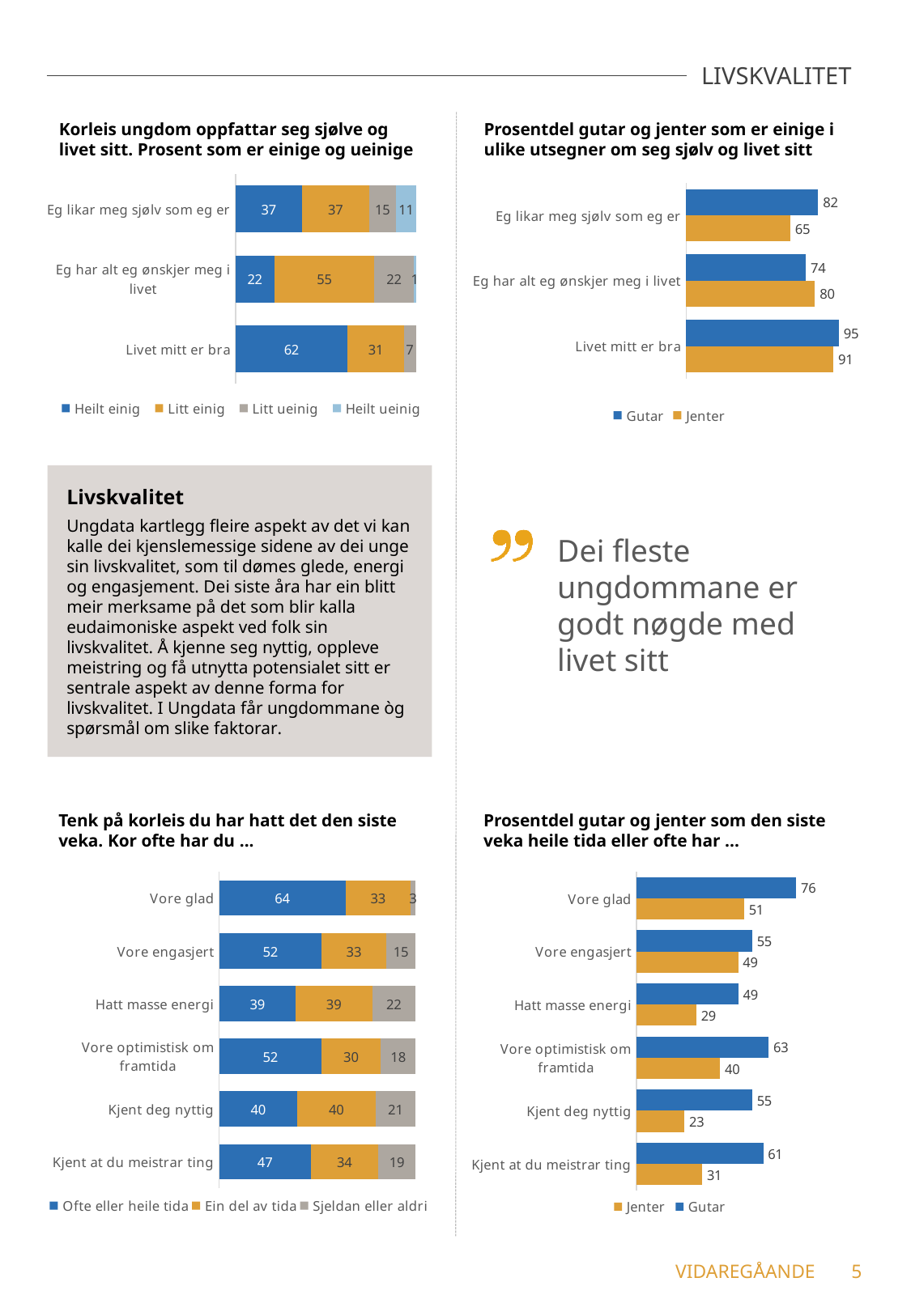
In the chart 'Prosentdel gutar og jenter som er einige i ulike utsegner om seg sjølv og livet sitt', what is the difference between Gutar and Jenter for 'Eg likar meg sjølv som eg er'? 17 In the chart 'Prosentdel gutar og jenter som er einige i ulike utsegner om seg sjølv og livet sitt', which is larger for 'Eg har alt eg ønskjer meg i livet', Gutar or Jenter? Jenter In the chart 'Prosentdel gutar og jenter som den siste veka heile tida eller ofte har …', what is the Jenter value for 'Kjent deg nyttig'? 23 In the chart 'Korleis ungdom oppfattar seg sjølve og livet sitt', how many series does the legend list? 4 In the chart 'Tenk på korleis du har hatt det den siste veka', how many categories are shown? 6 In the chart 'Prosentdel gutar og jenter som er einige i ulike utsegner om seg sjølv og livet sitt', what is the Jenter value for 'Eg likar meg sjølv som eg er'? 65 In the chart 'Tenk på korleis du har hatt det den siste veka', what is the 'Ofte eller heile tida' value for 'Kjent at du meistrar ting'? 47 In the chart 'Korleis ungdom oppfattar seg sjølve og livet sitt', what is the 'Heilt einig' value for 'Livet mitt er bra'? 62 In the chart 'Tenk på korleis du har hatt det den siste veka', which category has the highest 'Ofte eller heile tida' value? Vore glad What type of chart is 'Prosentdel gutar og jenter som den siste veka heile tida eller ofte har …'? Bar chart In the chart 'Prosentdel gutar og jenter som er einige i ulike utsegner om seg sjølv og livet sitt', which statement has the highest Gutar value? Livet mitt er bra In the chart 'Korleis ungdom oppfattar seg sjølve og livet sitt', what is the 'Litt einig' value for 'Eg har alt eg ønskjer meg i livet'? 55